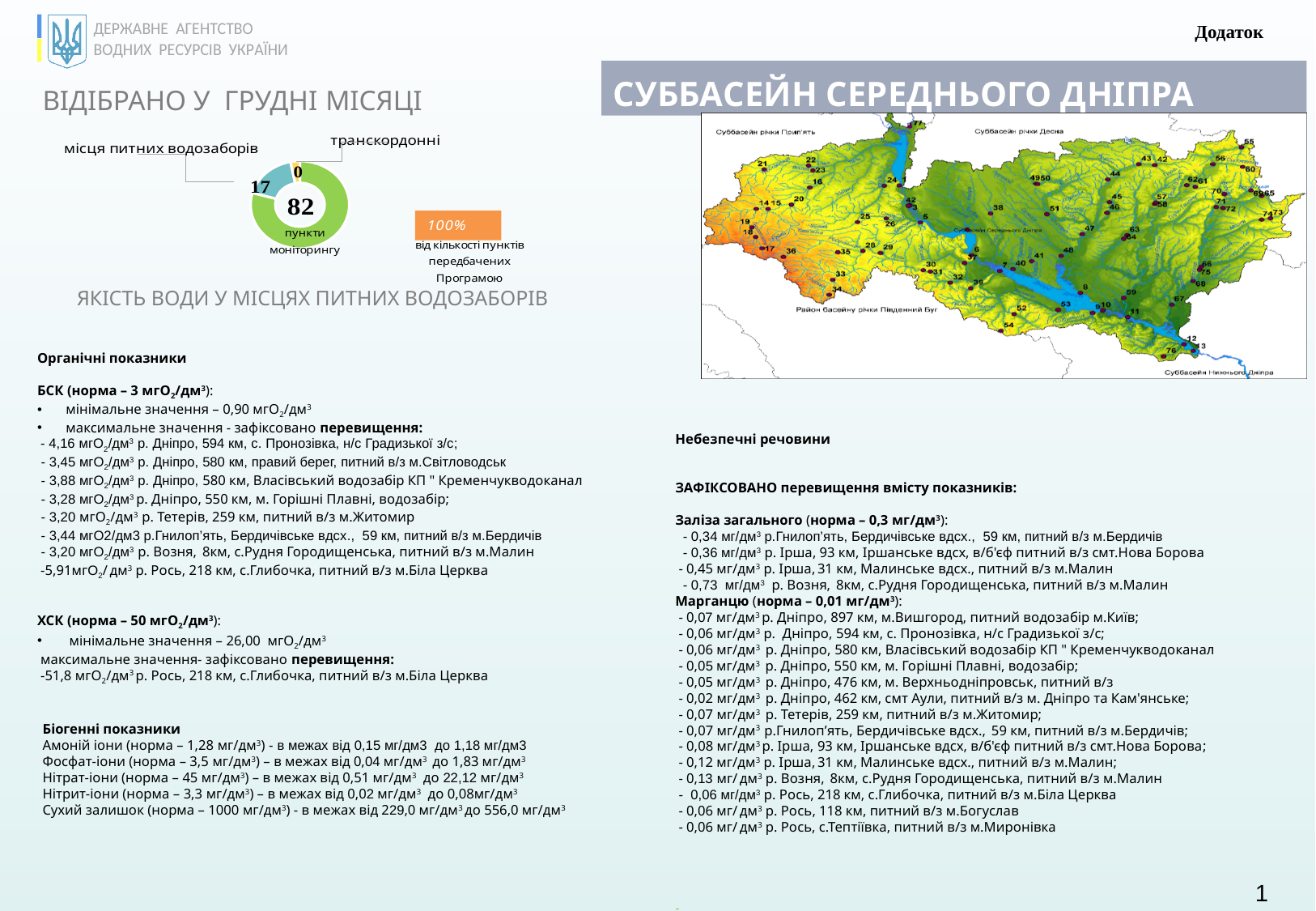
In the doughnut chart, which labelled category has the lowest value? транскордонні In the doughnut chart, what value is shown for "транскордонні"? 0 What kind of chart is shown under the heading "ВІДІБРАНО У ГРУДНІ МІСЯЦІ"? pie (doughnut) chart In the doughnut chart, what is the difference between the values for "місця питних водозаборів" and "транскордонні"? 17 What percentage is printed in the orange box next to the doughnut chart? 100% What number is printed in the centre of the doughnut chart? 82 In the doughnut chart, which is larger: "місця питних водозаборів" or "транскордонні"? місця питних водозаборів What label appears under the number 82 in the centre of the doughnut chart? пункти моніторингу In the doughnut chart, what value is shown for "місця питних водозаборів"? 17